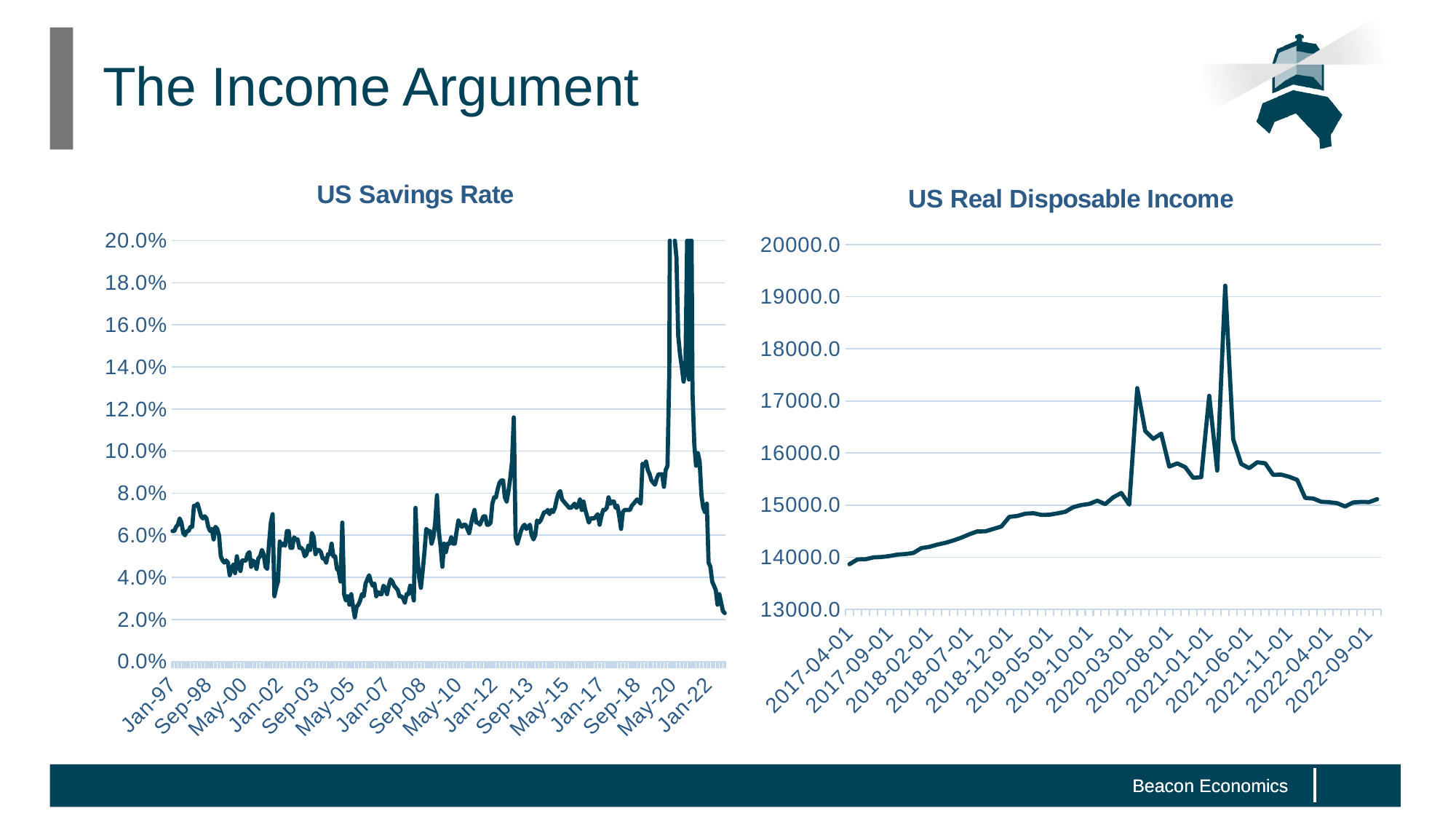
In the US Savings Rate chart, which is higher: the value at Jan-97 or the value at May-05? Jan-97 In the US Savings Rate chart, is the peak value around May-20 greater or less than 18.0%? greater In the US Savings Rate chart, is the value around May-05 greater or less than 4.0%? less In the US Savings Rate chart, does the savings rate rise or fall between May-05 and Sep-18? rise In the US Real Disposable Income chart, is the value at 2018-07-01 greater or less than 15000.0? less What kind of chart is the US Savings Rate chart? line chart What kind of chart is the US Real Disposable Income chart? line chart What is the title of the chart on the right side of the slide? US Real Disposable Income In the US Real Disposable Income chart, does real disposable income rise or fall between 2017-04-01 and 2019-10-01? rise In the US Real Disposable Income chart, which is higher: the value at 2017-04-01 or the value at 2022-09-01? 2022-09-01 In the US Savings Rate chart, does the savings rate rise or fall between Jan-97 and May-05? fall